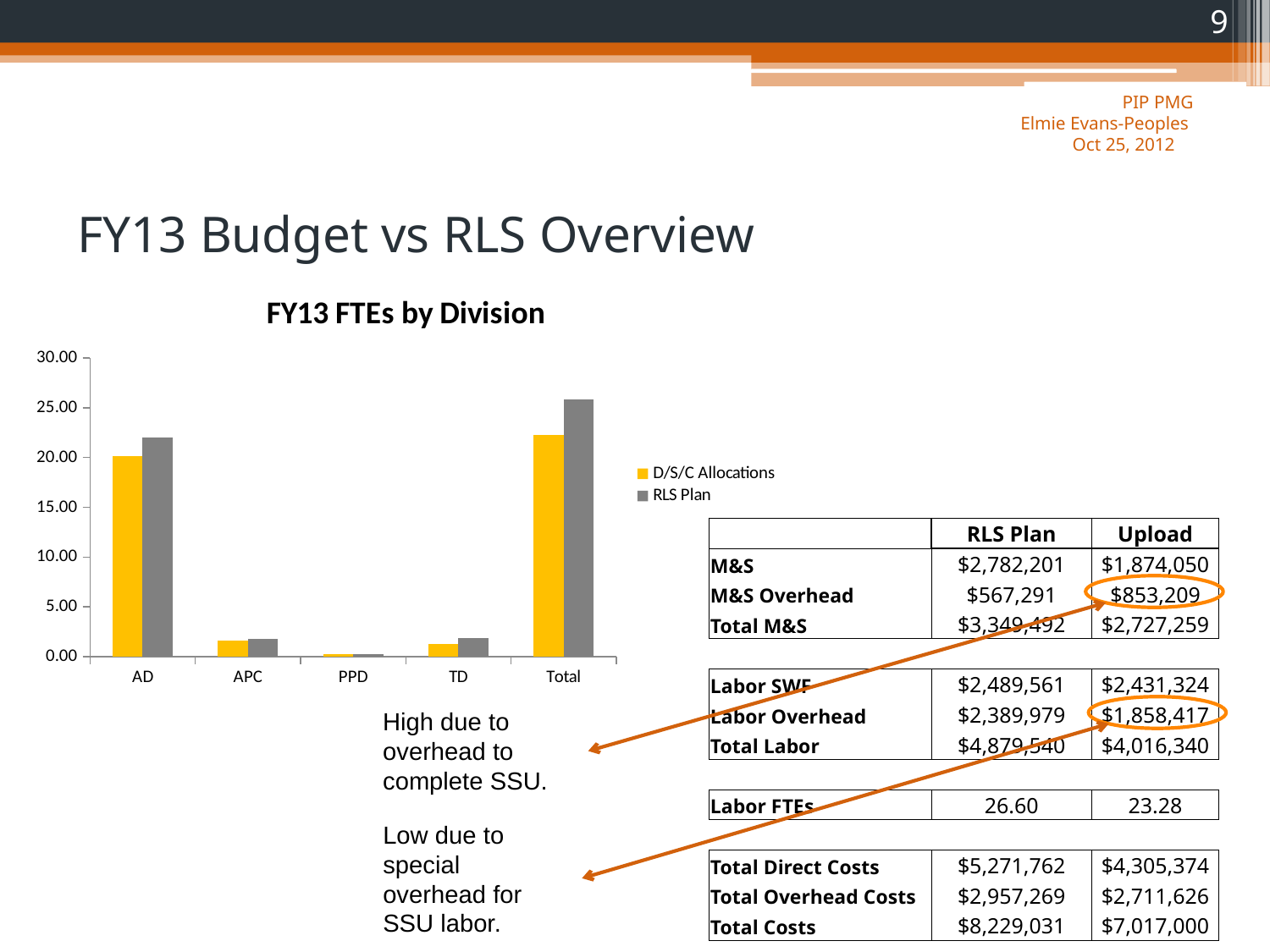
Is the D/S/C Allocations value for AD greater or less than 15.00? greater Which colour represents the RLS Plan series in the chart? gray What is the title of the chart on the slide? FY13 FTEs by Division Is the RLS Plan value for Total greater or less than 20.00? greater Which category has the lowest D/S/C Allocations value in the chart? PPD How many series does the chart's legend list? 2 For AD, which series has the larger value: D/S/C Allocations or RLS Plan? RLS Plan What kind of chart is shown on the slide? bar chart For Total, which series has the larger value: D/S/C Allocations or RLS Plan? RLS Plan Which category has the highest RLS Plan value in the chart? Total How many categories are shown on the x axis of the chart? 5 Is the D/S/C Allocations value for APC greater or less than 5.00? less